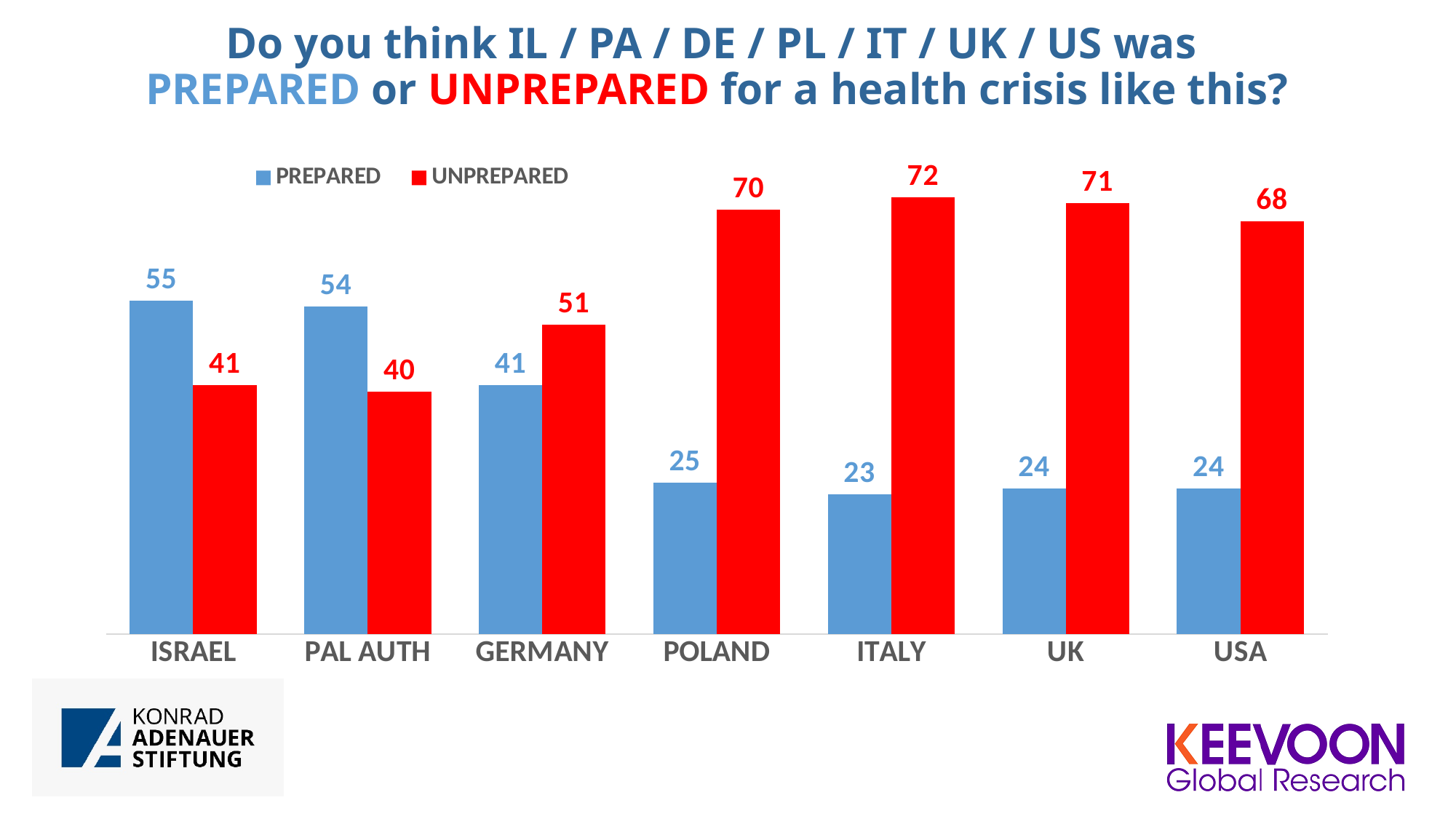
What is the PREPARED value for Israel? 55 What kind of chart is shown on the slide? Bar chart What is the PREPARED value for Italy? 23 What is the difference between the UNPREPARED and PREPARED values for the UK? 47 For Germany, which is larger: the PREPARED value or the UNPREPARED value? UNPREPARED What colour are the UNPREPARED bars? Red How many countries are shown on the x axis? 7 How many series does the legend list? 2 For Pal Auth, which is larger: the PREPARED value or the UNPREPARED value? PREPARED What is the UNPREPARED value for Poland? 70 Which country has the lowest PREPARED value? Italy Which country has the highest UNPREPARED value? Italy